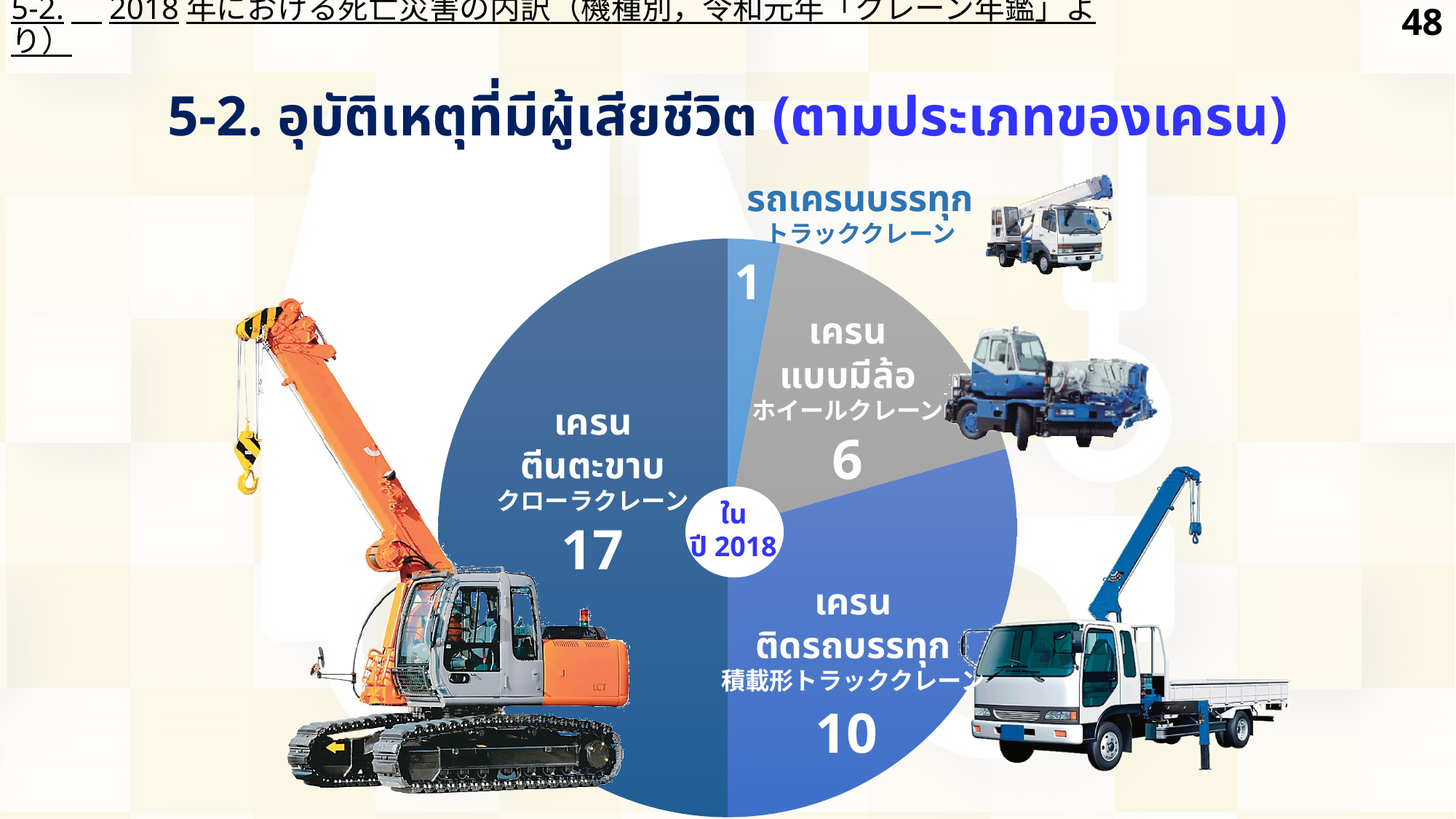
What is the difference between the crawler crane value and the truck-mounted crane value? 7 What is the value shown for the crawler crane (เครนตีนตะขาบ / クローラクレーン) slice? 17 Which crane type has the smallest slice in the pie chart? รถเครนบรรทุก (トラッククレーン, truck crane) How many slices does the pie chart have? 4 Which is larger, the wheel crane value or the truck-mounted crane value? truck-mounted crane (เครนติดรถบรรทุก), 10 What kind of chart is shown on the slide? pie chart What is the value shown for the truck crane (รถเครนบรรทุก / トラッククレーン) slice? 1 What year is shown in the centre of the pie chart? 2018 What share of the pie does the crawler crane slice (17) represent? 50% What is the value shown for the wheel crane (เครนแบบมีล้อ / ホイールクレーン) slice? 6 Which crane type has the largest slice in the pie chart? เครนตีนตะขาบ (クローラクレーン, crawler crane) What is the value shown for the truck-mounted crane (เครนติดรถบรรทุก / 積載形トラッククレーン) slice? 10